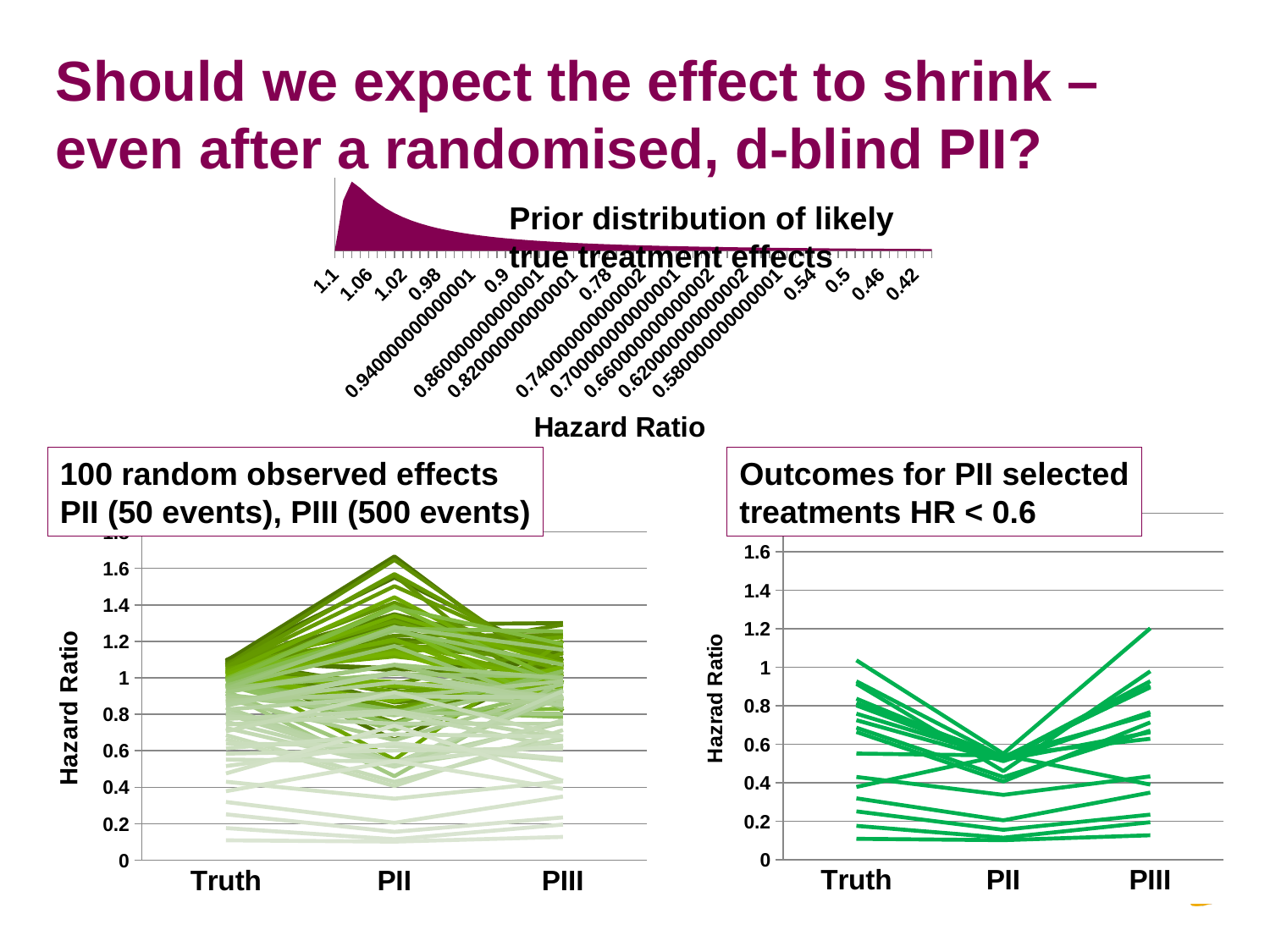
In the top chart 'Prior distribution of likely true treatment effects', does the plotted area rise or fall moving from left to right along the x axis? fall In the bottom-right chart 'Outcomes for PII selected treatments HR < 0.6', is the highest value at PII greater or less than 0.8? less What kind of chart is the bottom-left chart '100 random observed effects PII (50 events), PIII (500 events)'? line chart In the bottom-left chart '100 random observed effects PII (50 events), PIII (500 events)', is the highest value at PII greater or less than 1.6? greater What kind of chart is the top chart titled 'Prior distribution of likely true treatment effects'? area chart In the bottom-left chart '100 random observed effects PII (50 events), PIII (500 events)', is the highest value at Truth greater or less than 1.4? less What kind of chart is the bottom-right chart 'Outcomes for PII selected treatments HR < 0.6'? line chart What is the y-axis title of the bottom-right chart 'Outcomes for PII selected treatments HR < 0.6', as printed on the slide? Hazrad Ratio In the top chart 'Prior distribution of likely true treatment effects', what is the x-axis title? Hazard Ratio How many categories are on the x axis of the bottom-left chart '100 random observed effects PII (50 events), PIII (500 events)'? 3 In the bottom-left chart '100 random observed effects PII (50 events), PIII (500 events)', at which x-axis category does the highest line reach its peak? PII